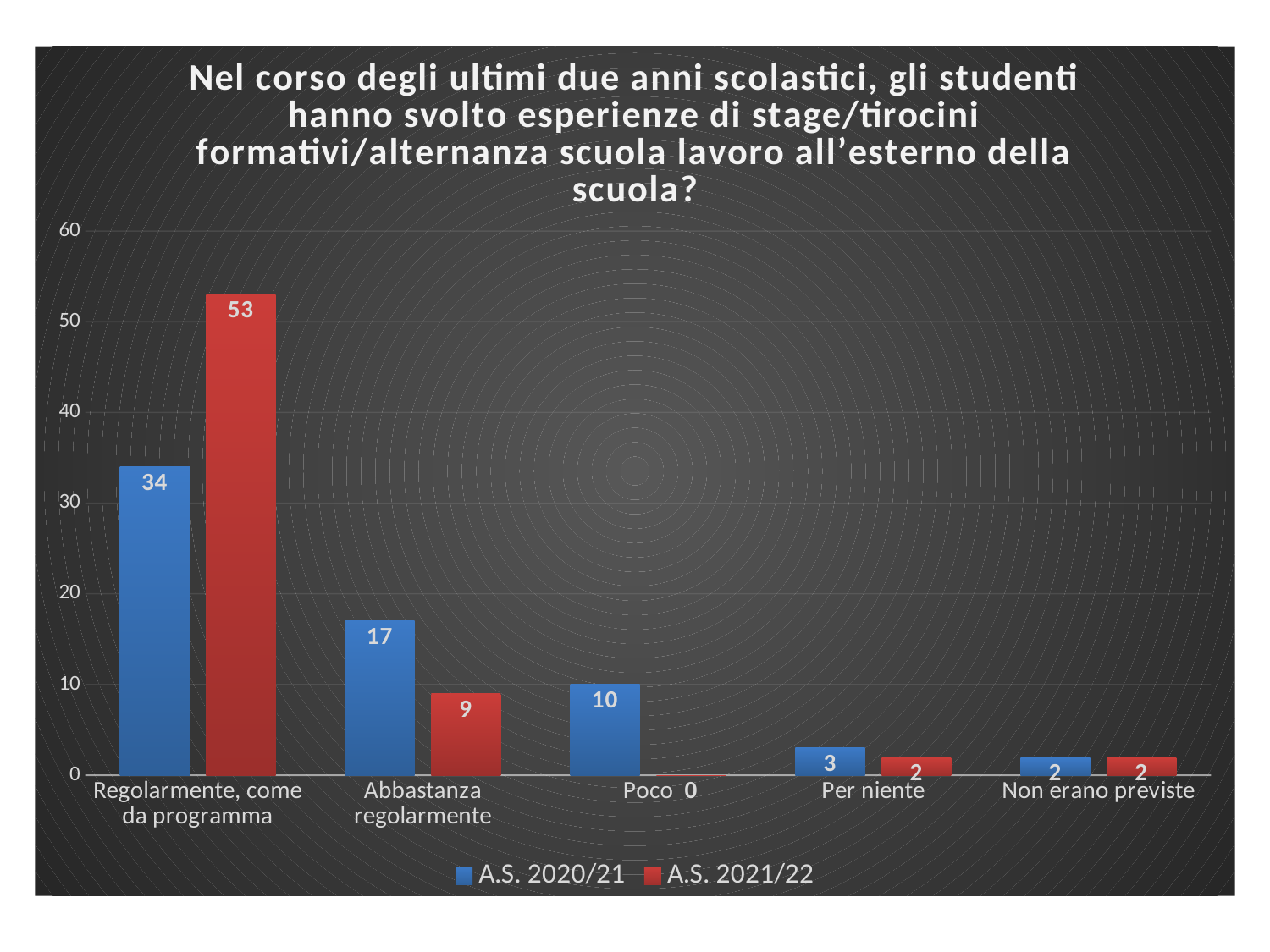
Which is larger for "Abbastanza regolarmente": the A.S. 2020/21 value or the A.S. 2021/22 value? A.S. 2020/21 How many categories are shown on the x axis? 5 Is the A.S. 2021/22 value for "Regolarmente, come da programma" greater or less than 50? greater What is the value for "Regolarmente, come da programma" in the A.S. 2021/22 series? 53 What is the difference between the A.S. 2021/22 and A.S. 2020/21 values for "Regolarmente, come da programma"? 19 Which colour represents the A.S. 2021/22 series? red What is the value for "Poco" in the A.S. 2021/22 series? 0 How many series does the legend list? 2 What kind of chart is shown on the slide? bar chart What is the value for "Abbastanza regolarmente" in the A.S. 2020/21 series? 17 Which category has the lowest value in the A.S. 2021/22 series? Poco Which category has the highest value in the A.S. 2020/21 series? Regolarmente, come da programma